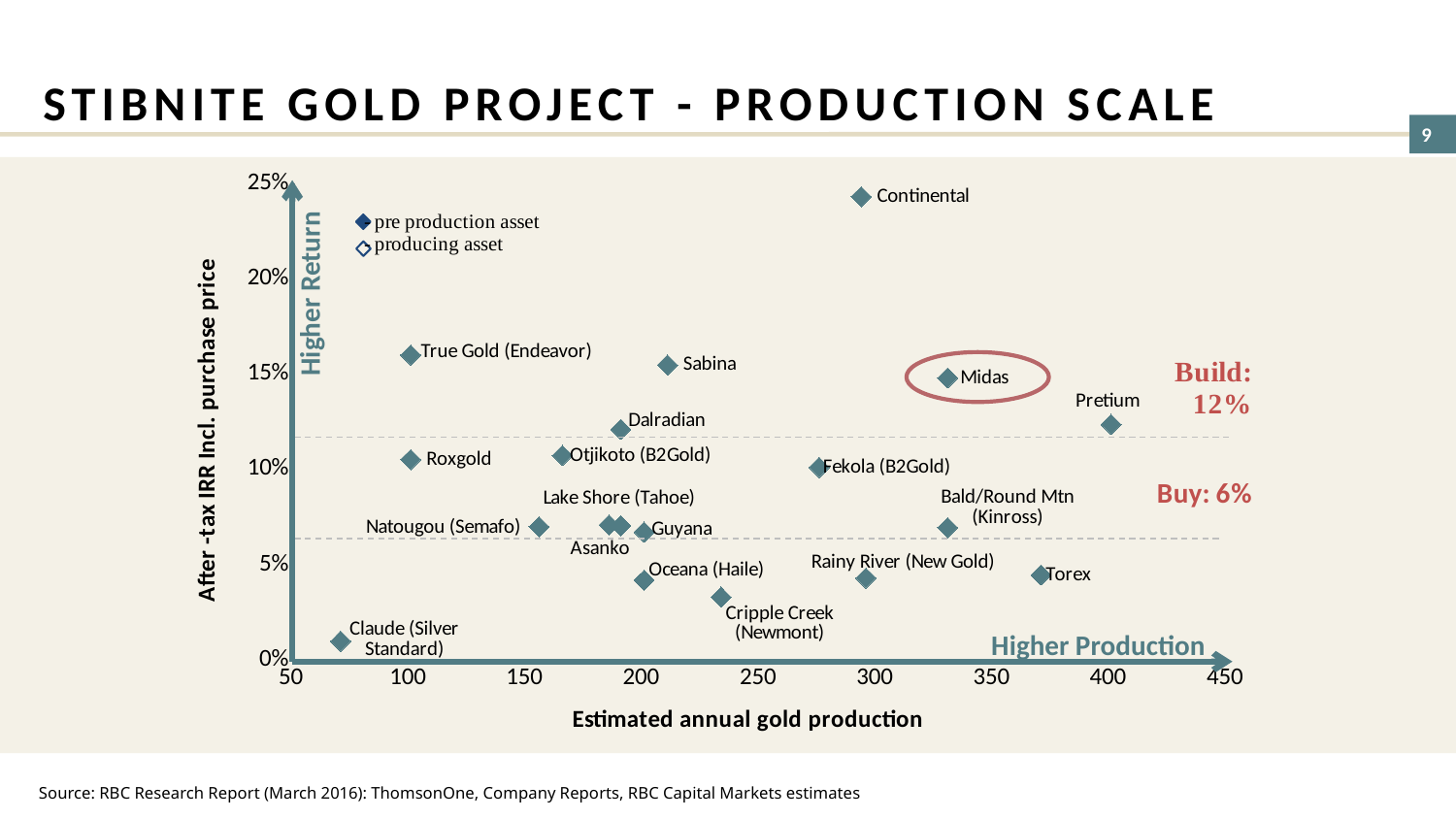
What kind of chart is shown on the slide? Scatter chart Which project is circled on the chart? Midas Is the after-tax IRR for Claude (Silver Standard) greater or less than 5%? less Which has a higher after-tax IRR, Sabina or Torex? Sabina Is the estimated annual gold production for Pretium greater or less than 350? greater How many entries does the chart legend list? 2 Which project has the highest estimated annual gold production on the chart? Pretium What is the label on the x axis of the chart? Estimated annual gold production Which project has the lowest after-tax IRR on the chart? Claude (Silver Standard) Which project has the highest after-tax IRR on the chart? Continental Is the estimated annual gold production for True Gold (Endeavor) greater or less than 150? less